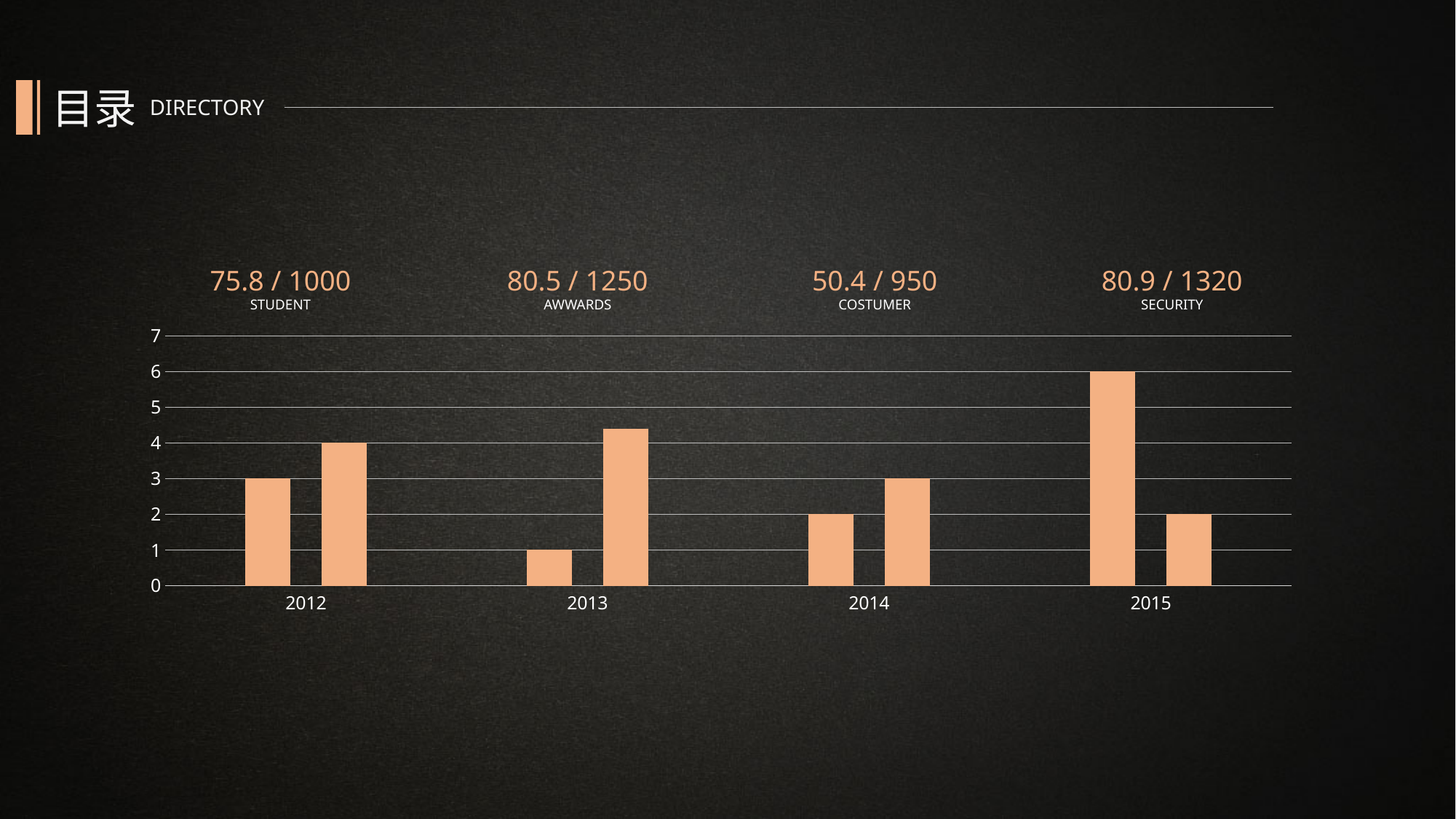
What kind of chart is shown on the slide? bar chart What is the value of the shorter bar for 2015? 2 Is the value of the taller bar for 2013 greater or less than 4? greater What is the highest value shown on the vertical axis of the chart? 7 What is the value of the shorter bar for 2013? 1 What is the difference between the two bars for 2015? 4 What is the value of the taller bar for 2012? 4 Which year has the shortest bar in the chart? 2013 What is the value of the taller bar for 2015? 6 What is the value of the shorter bar for 2012? 3 Which year has the tallest bar in the chart? 2015 How many year categories are shown on the x axis of the chart? 4